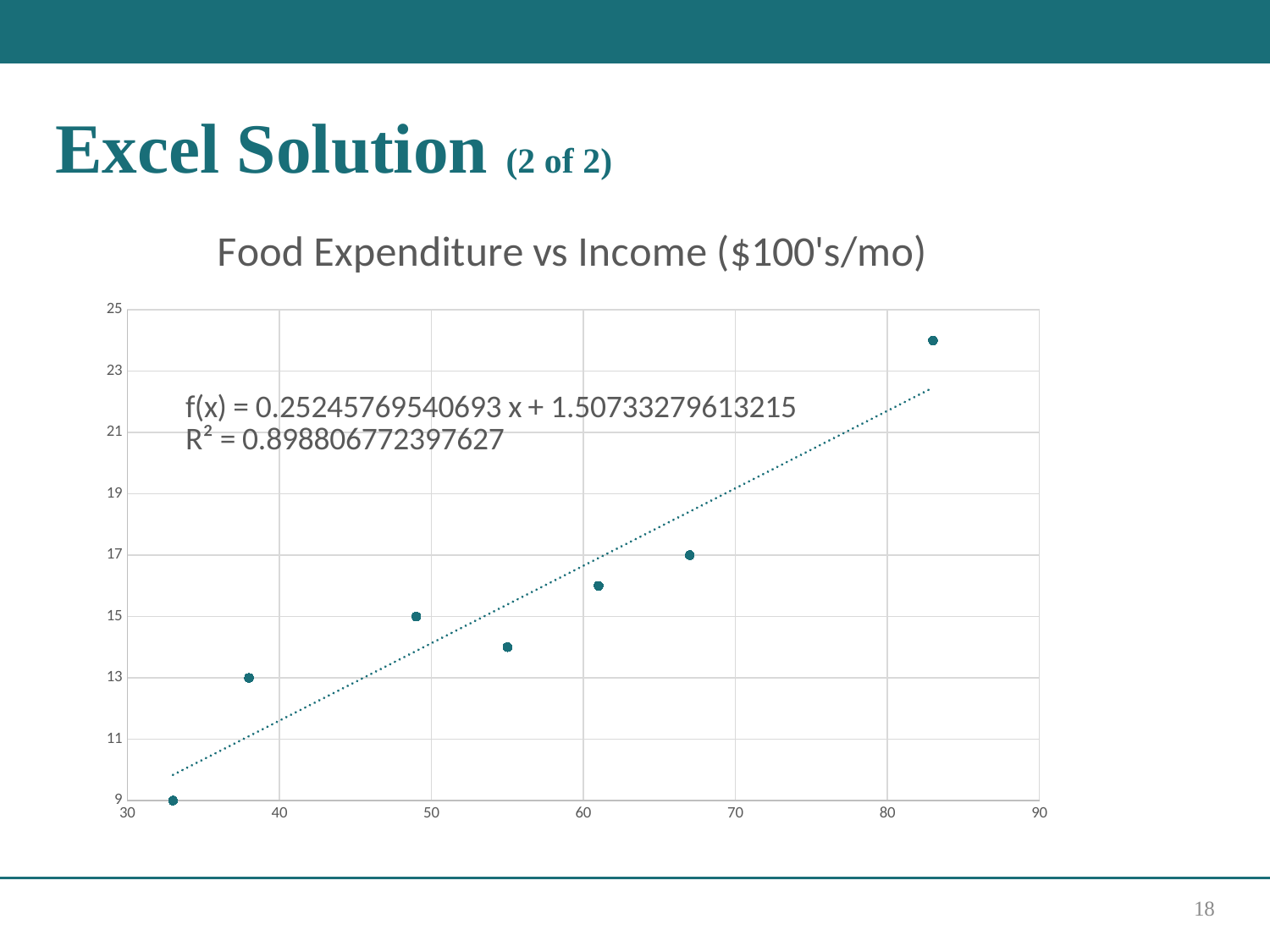
What is the y value of the lowest data point on the chart? 9 How many data points are plotted on the chart? 7 Is the y value of the highest data point greater or less than 23? greater What kind of chart is shown on the slide? scatter chart Which has the larger y value: the data point just below x = 50 or the data point between x = 50 and x = 60? the data point just below x = 50 Is the x value of the highest data point greater or less than 80? greater Is the y value of the data point located between x = 50 and x = 60 greater or less than 15? less What is the y value of the data point located between x = 30 and x = 40 that lies on a gridline above the lowest point? 13 Do the plotted values generally rise or fall as income increases along the x axis? rise What is the slope of the trendline equation printed on the chart? 0.25245769540693 What R² value is printed on the chart? 0.898806772397627